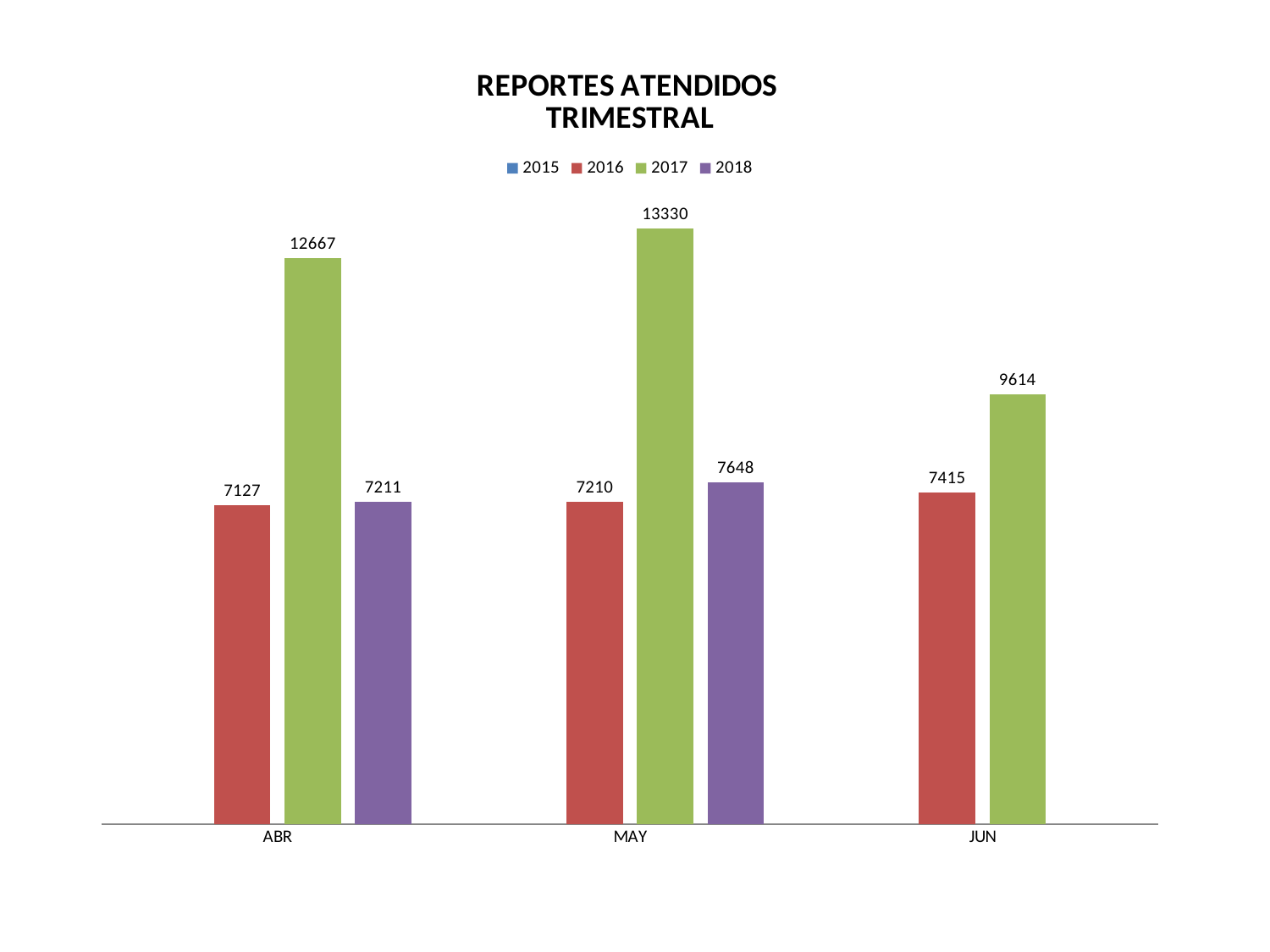
What is the difference between the 2017 values in MAY and JUN? 3716 In which month is the 2016 value lowest? ABR What is the value for 2017 in JUN? 9614 How many months are shown on the x axis? 3 Which is larger in MAY, the 2017 value or the 2018 value? 2017 How many series does the legend list? 4 What is the value for 2016 in ABR? 7127 In which month is the 2017 value highest? MAY What is the value for 2017 in MAY? 13330 What is the difference between the 2017 and 2016 values in ABR? 5540 What is the value for 2018 in MAY? 7648 What kind of chart is shown on the slide? Bar chart